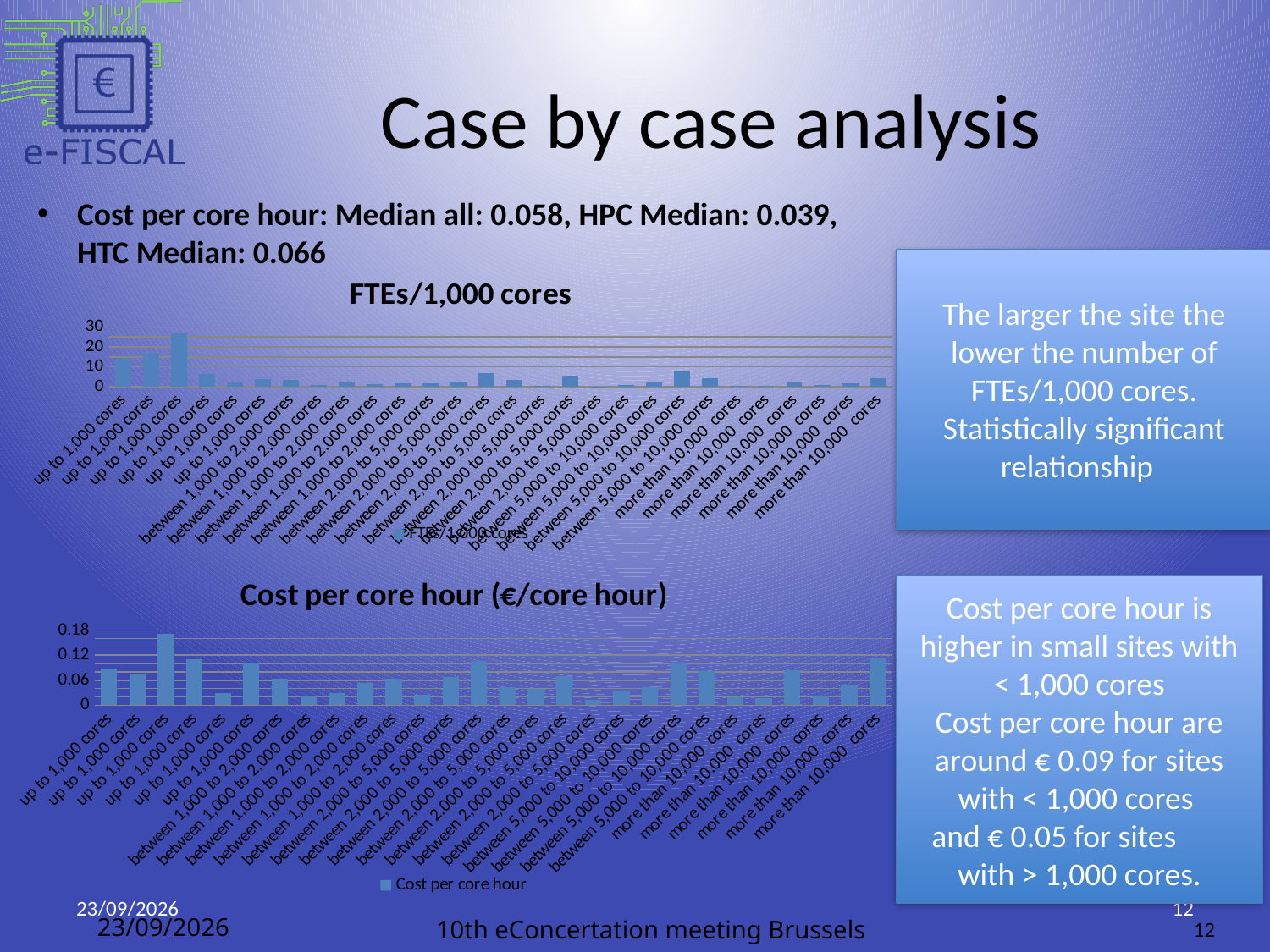
What is the title of the bottom chart on the slide? Cost per core hour (€/core hour) In the 'Cost per core hour (€/core hour)' chart, is the tallest bar greater or less than 0.12? greater In the 'FTEs/1,000 cores' chart, is the tallest bar greater or less than 20? greater What type of chart is the top chart titled 'FTEs/1,000 cores'? bar chart In the 'FTEs/1,000 cores' chart, is the tallest bar greater or less than 30? less What is the title of the top chart on the slide? FTEs/1,000 cores In the 'Cost per core hour (€/core hour)' chart, which site-size group contains the tallest bar? up to 1,000 cores In the 'FTEs/1,000 cores' chart, do the bar heights generally rise or fall as site size increases along the x axis? fall How many series does the legend of the 'Cost per core hour (€/core hour)' chart list? 1 In the 'FTEs/1,000 cores' chart, which site-size group contains the tallest bar? up to 1,000 cores How many series does the legend of the 'FTEs/1,000 cores' chart list? 1 What type of chart is the bottom chart titled 'Cost per core hour (€/core hour)'? bar chart